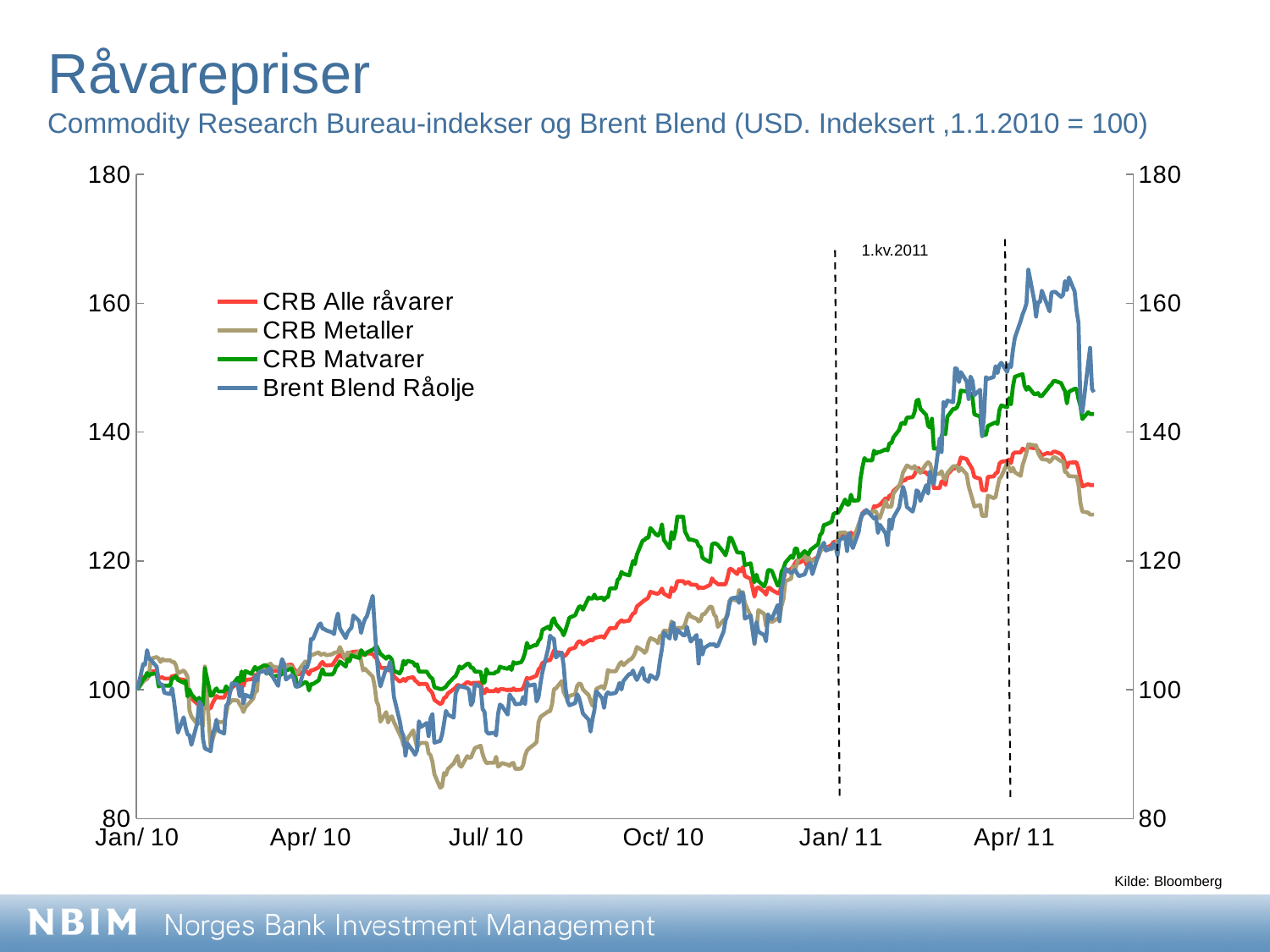
Which series reaches the lowest value anywhere on the chart? CRB Metaller At Apr/ 11, which is higher: Brent Blend Råolje or CRB Alle råvarer? Brent Blend Råolje What kind of chart is shown on the slide? line chart What label is written next to the dashed vertical lines on the chart? 1.kv.2011 Is the value for CRB Matvarer at Oct/ 10 greater or less than 120? greater Which series are listed in the legend? CRB Alle råvarer, CRB Metaller, CRB Matvarer, Brent Blend Råolje Which series reaches the highest value anywhere on the chart? Brent Blend Råolje How many series does the legend list? 4 Is the highest value reached by Brent Blend Råolje greater or less than 160? greater Does CRB Metaller rise or fall between Apr/ 10 and Jul/ 10? fall Does CRB Matvarer rise or fall between Jul/ 10 and Jan/ 11? rise Is the lowest value reached by CRB Metaller greater or less than 90? less